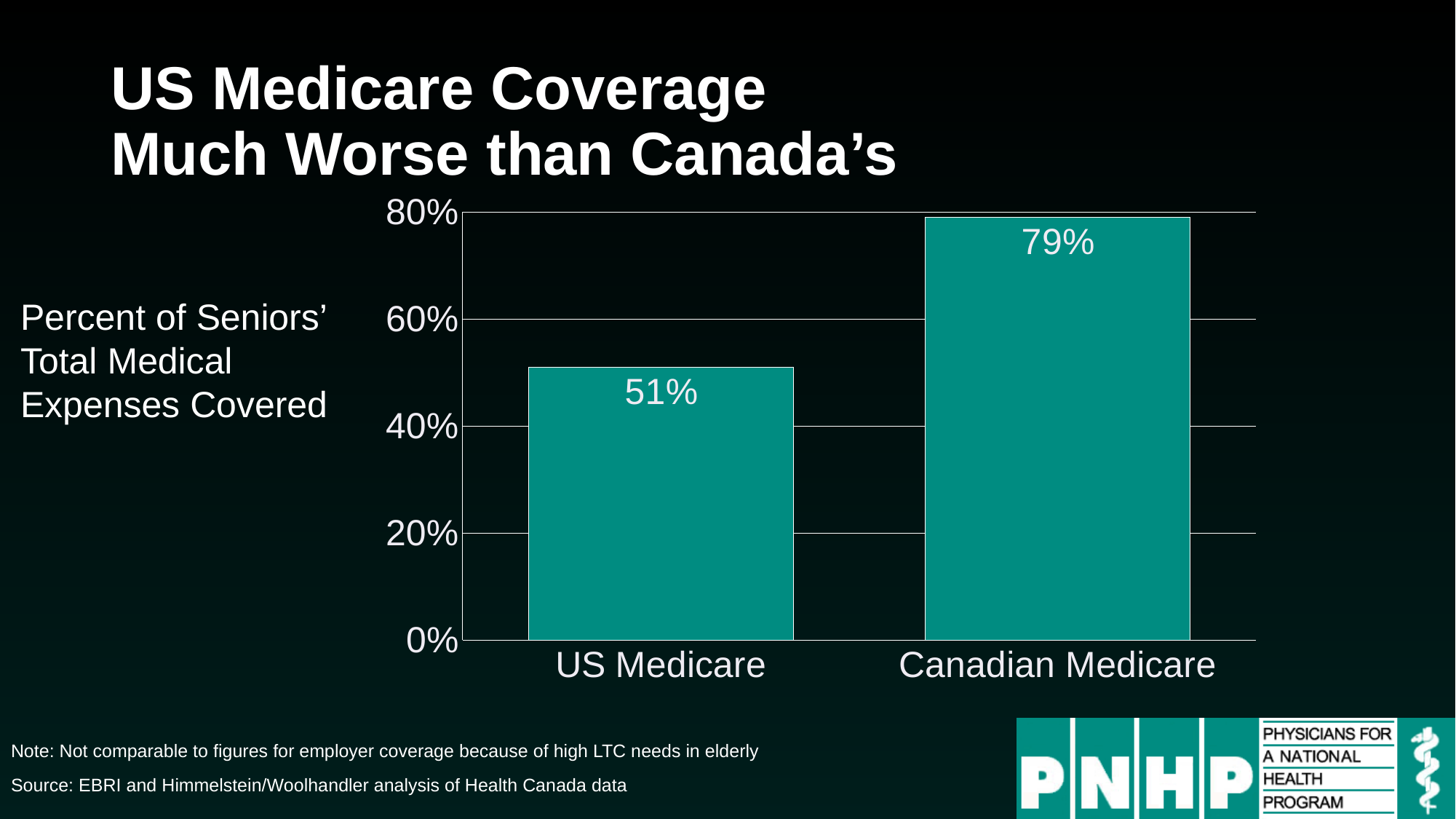
What is the difference between the Canadian Medicare and US Medicare values? 28% What percent of seniors' total medical expenses does US Medicare cover? 51% What does the chart measure, according to the label to its left? Percent of Seniors' Total Medical Expenses Covered How many categories are shown on the chart? 2 Is the value for Canadian Medicare greater or less than 60%? greater Is the value for US Medicare greater or less than 60%? less What kind of chart is shown on the slide? bar chart What percent of seniors' total medical expenses does Canadian Medicare cover? 79% What is the highest value shown on the y axis? 80% Which category has the highest value? Canadian Medicare Which category has the lowest value? US Medicare Which is larger, the value for US Medicare or the value for Canadian Medicare? Canadian Medicare